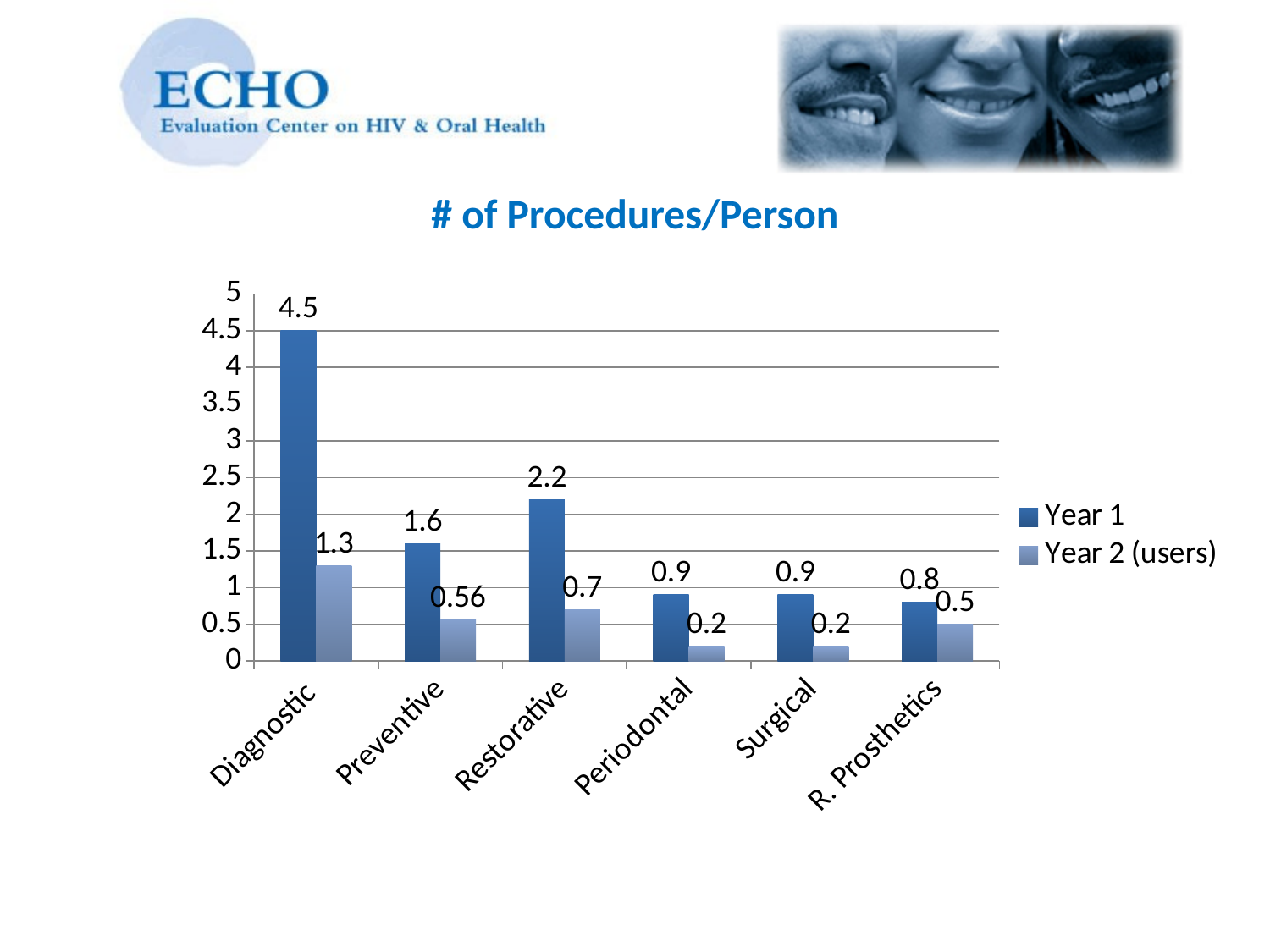
What kind of chart is shown? bar chart What is the Year 1 value for Restorative? 2.2 What is the Year 2 (users) value for Preventive? 0.56 Is the Year 1 value for Preventive greater or less than 1? greater Which is larger, the Year 2 (users) value for Restorative or for R. Prosthetics? Restorative Which category has the lowest Year 1 value? R. Prosthetics What is the Year 1 value for Diagnostic? 4.5 How many categories are shown on the x axis? 6 How many series does the legend list? 2 What is the difference between the Year 1 and Year 2 (users) values for Diagnostic? 3.2 Which category has the highest Year 1 value? Diagnostic What is the title of the chart? # of Procedures/Person